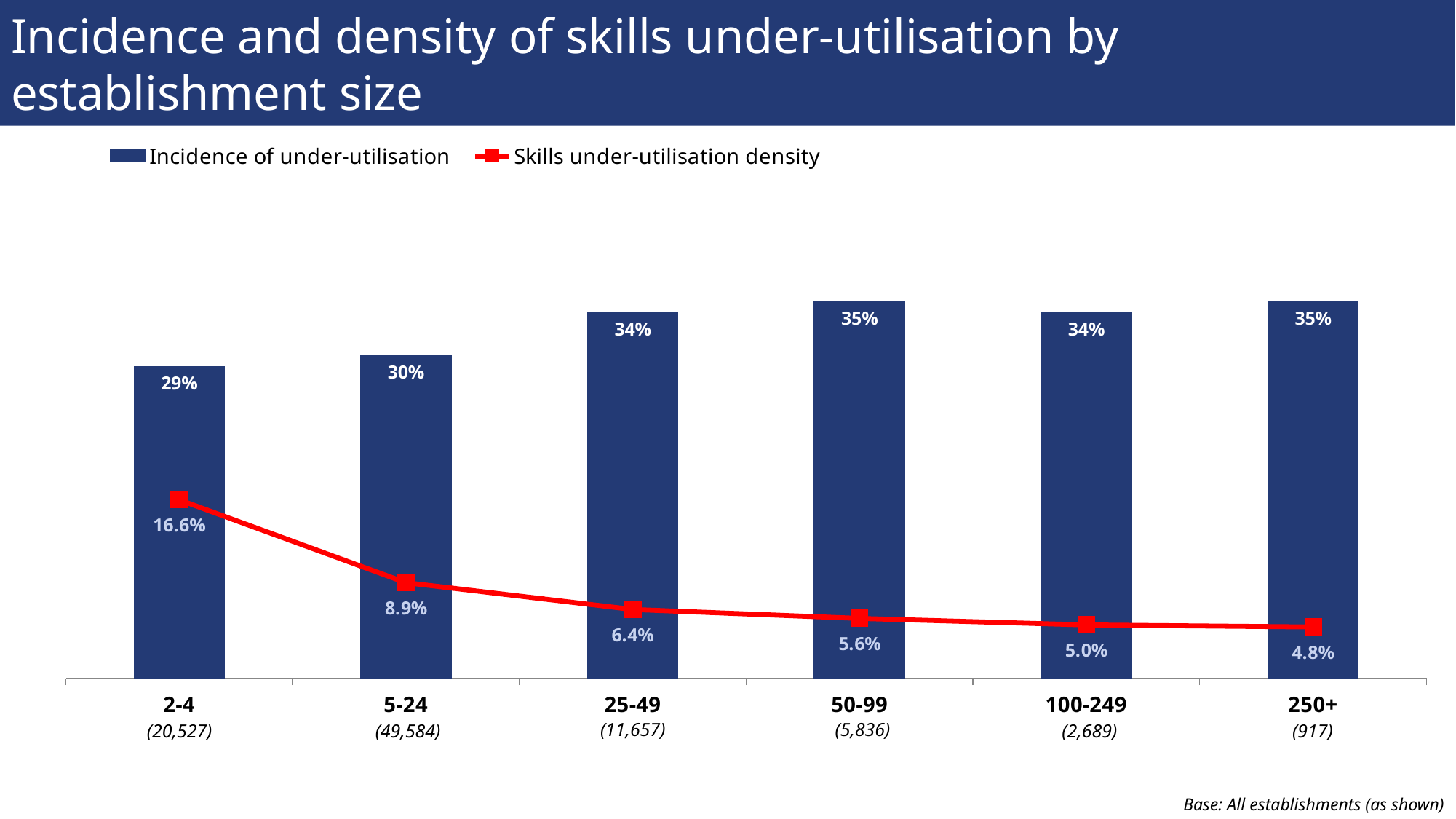
Which establishment size has the lowest skills under-utilisation density? 250+ What is the incidence of under-utilisation for establishments of size 100-249? 34% How many series does the legend list? 2 Which establishment size has the highest skills under-utilisation density? 2-4 What is the skills under-utilisation density for establishments of size 250+? 4.8% What is the difference in skills under-utilisation density between the 2-4 and 5-24 size bands? 7.7% Which is larger: the incidence of under-utilisation for 25-49 or for 50-99? 50-99 Which establishment size has the lowest incidence of under-utilisation? 2-4 What is the incidence of under-utilisation for establishments of size 2-4? 29% What is the skills under-utilisation density for establishments of size 5-24? 8.9% Does the skills under-utilisation density rise or fall as establishment size increases along the x axis? fall How many establishment size bands are shown on the x axis? 6